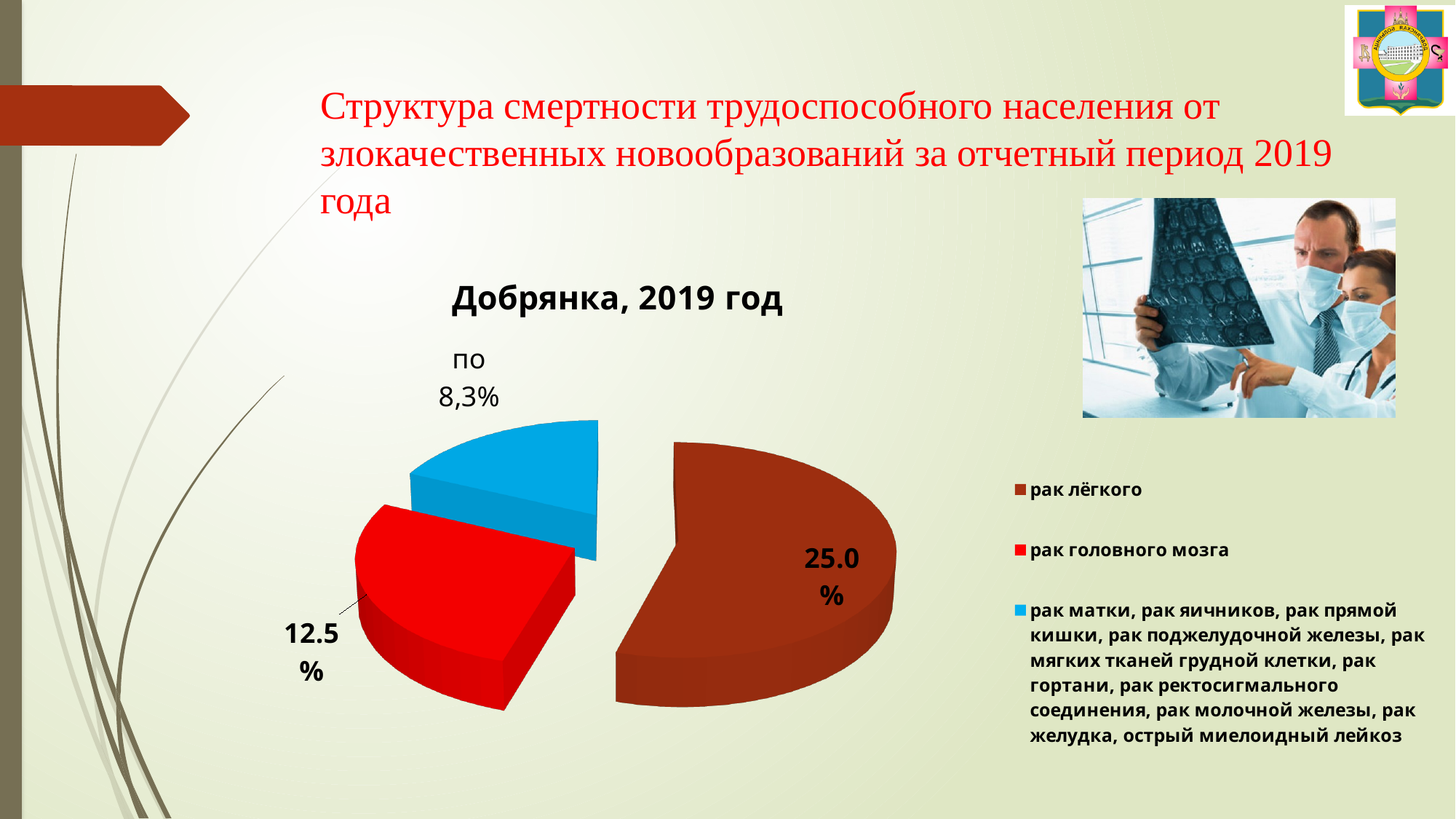
What colour is the slice for рак головного мозга? red What percentage is shown for рак головного мозга? 12.5 % Which is larger, the share for рак лёгкого or for рак головного мозга? рак лёгкого What is the title of the chart? Добрянка, 2019 год Which category has the largest slice of the pie? рак лёгкого What percentage is shown for рак лёгкого? 25.0 % What kind of chart is shown on the slide? pie chart What is the difference between the percentages for рак лёгкого and рак головного мозга? 12.5 % How many entries does the legend list? 3 What label is printed next to the blue slice of the pie? по 8,3% How many slices does the pie chart have? 3